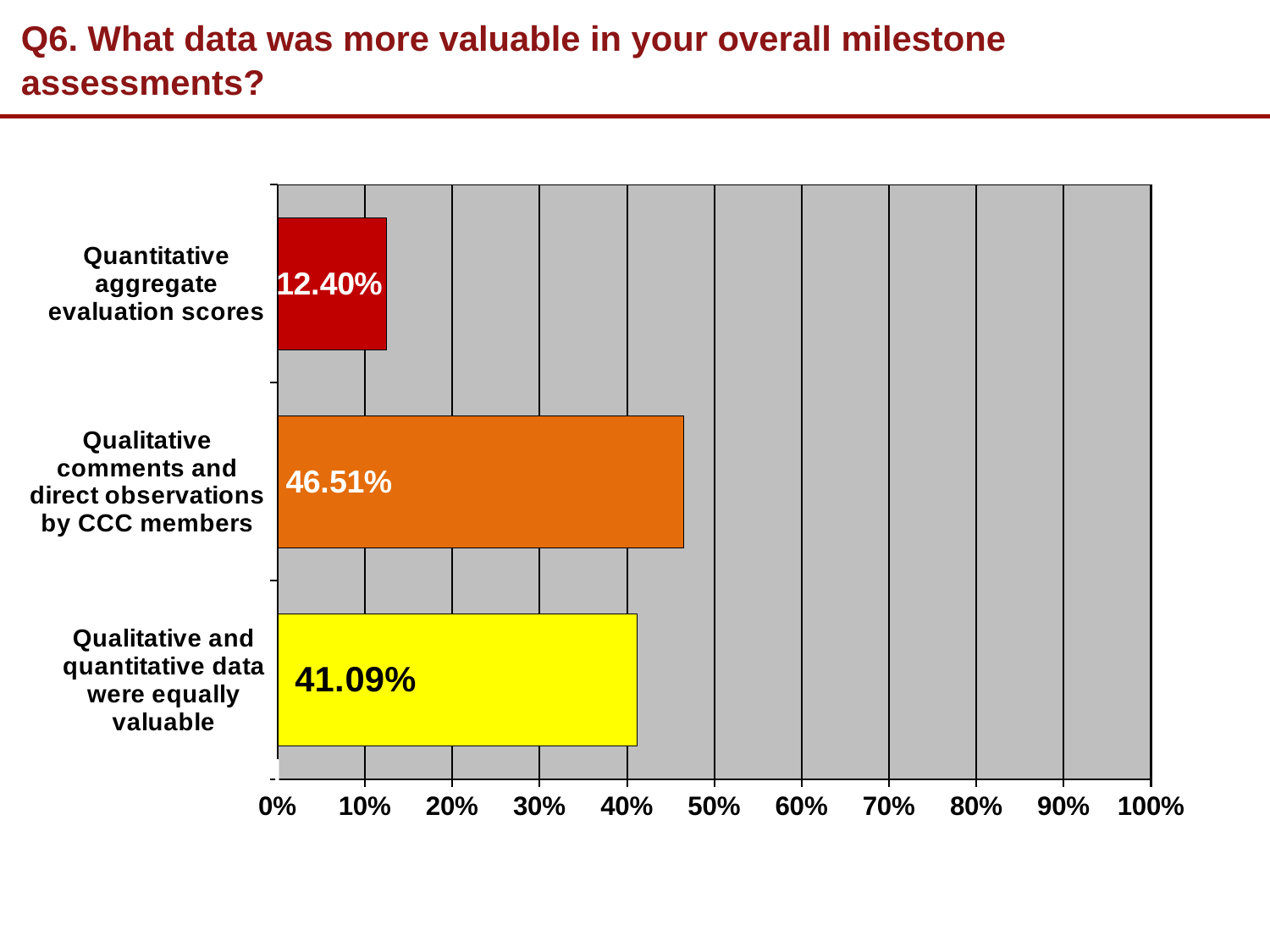
What percentage of respondents chose 'Quantitative aggregate evaluation scores'? 12.40% Which category has the lowest value? Quantitative aggregate evaluation scores Which is larger: the value for 'Quantitative aggregate evaluation scores' or for 'Qualitative and quantitative data were equally valuable'? Qualitative and quantitative data were equally valuable How many categories are shown in the chart? 3 What is the value for 'Qualitative comments and direct observations by CCC members'? 46.51% What kind of chart is shown on the slide? Bar chart Is the value for 'Qualitative comments and direct observations by CCC members' greater or less than 50%? less What percentage said 'Qualitative and quantitative data were equally valuable'? 41.09% Which category has the highest value? Qualitative comments and direct observations by CCC members What is the difference between the values for 'Qualitative and quantitative data were equally valuable' and 'Quantitative aggregate evaluation scores'? 28.69% What is the difference between the values for 'Qualitative comments and direct observations by CCC members' and 'Qualitative and quantitative data were equally valuable'? 5.42% What is the title of the slide? Q6. What data was more valuable in your overall milestone assessments?